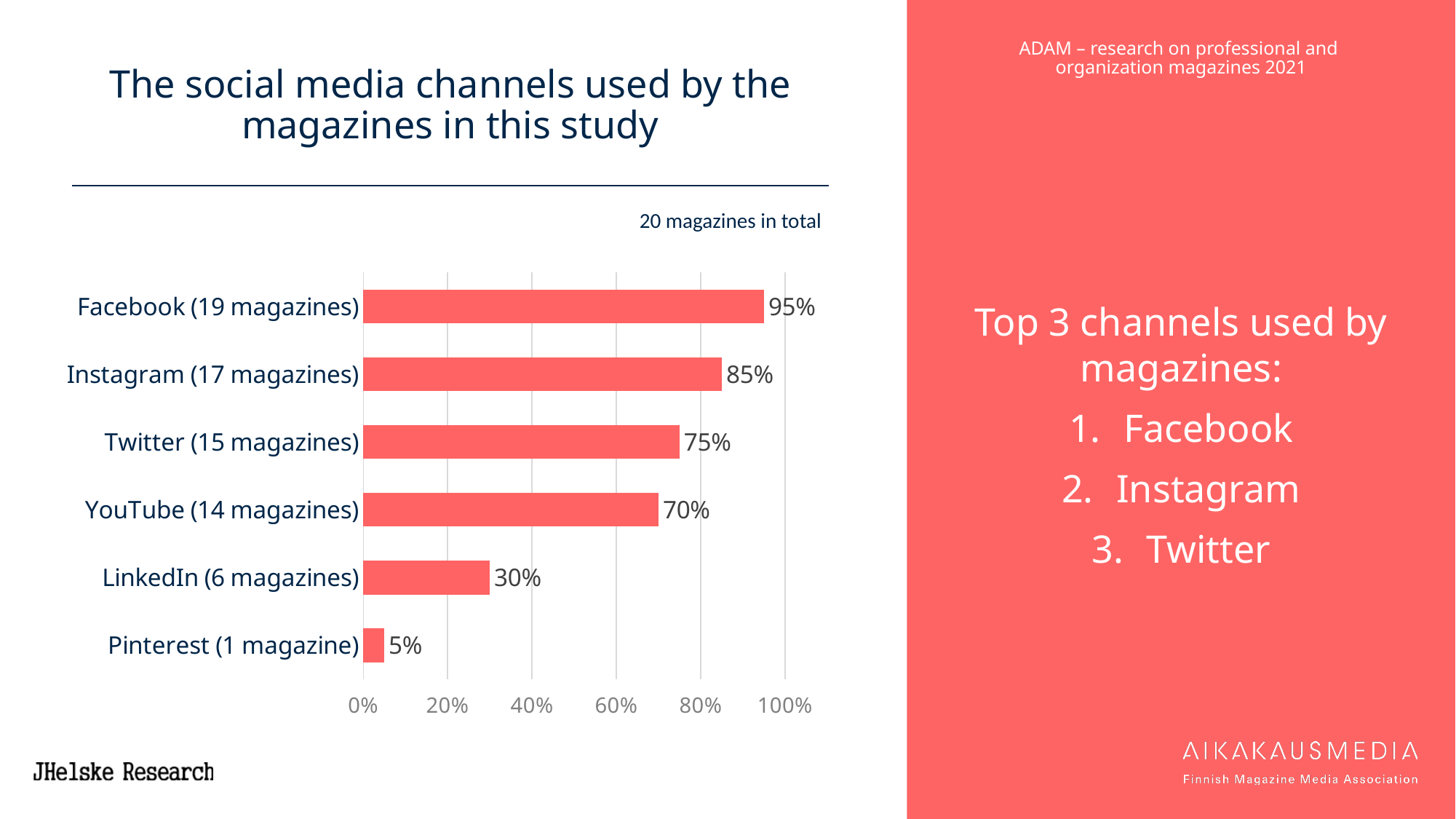
Which social media channel has the lowest value in the chart? Pinterest What is the difference in percentage points between Instagram and Twitter? 10% Which social media channel has the highest value in the chart? Facebook What is the difference in percentage points between Facebook and Pinterest? 90% Is the value for Twitter greater or less than 60%? greater What type of chart is shown on the slide? Bar chart How many social media channels are shown in the chart? 6 What percentage of magazines use Facebook? 95% Which has a higher value, YouTube or LinkedIn? YouTube What is the value shown for YouTube? 70% How many magazines in total does the chart note say were included? 20 magazines in total What percentage of magazines use LinkedIn? 30%